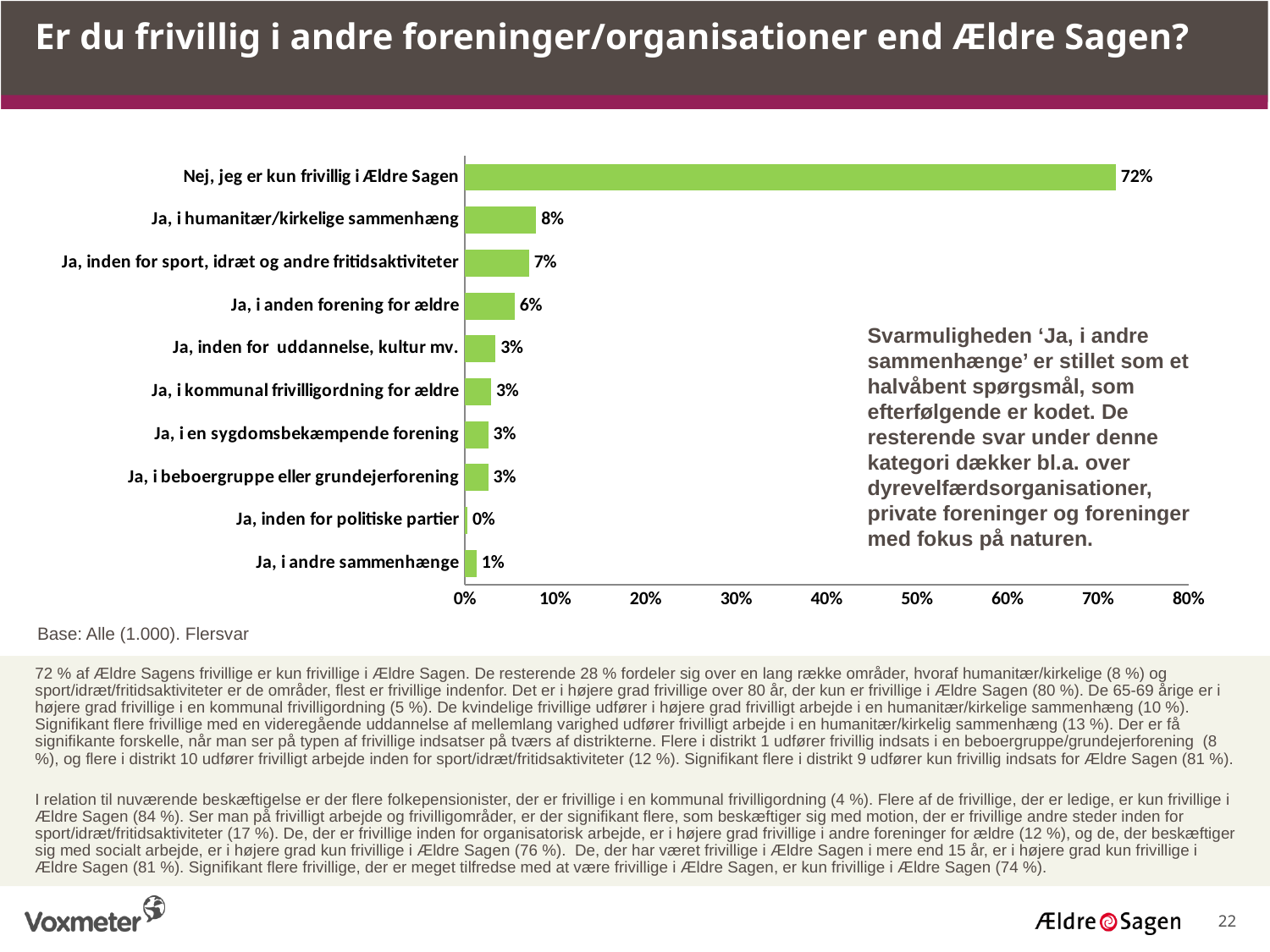
What kind of chart is shown on the slide? Bar chart Which category has the lowest value? Ja, inden for politiske partier What is the value for "Ja, i humanitær/kirkelige sammenhæng"? 8% What is the value for "Ja, inden for politiske partier"? 0% What is the difference between "Nej, jeg er kun frivillig i Ældre Sagen" and "Ja, i humanitær/kirkelige sammenhæng"? 64% Is the value for "Nej, jeg er kun frivillig i Ældre Sagen" greater or less than 70%? greater What is the value for "Ja, i anden forening for ældre"? 6% Which is larger: "Ja, i anden forening for ældre" or "Ja, i andre sammenhænge"? Ja, i anden forening for ældre What is the value for "Nej, jeg er kun frivillig i Ældre Sagen"? 72% How many categories are shown in the chart? 10 What is the value for "Ja, inden for sport, idræt og andre fritidsaktiviteter"? 7% Which category has the highest value? Nej, jeg er kun frivillig i Ældre Sagen